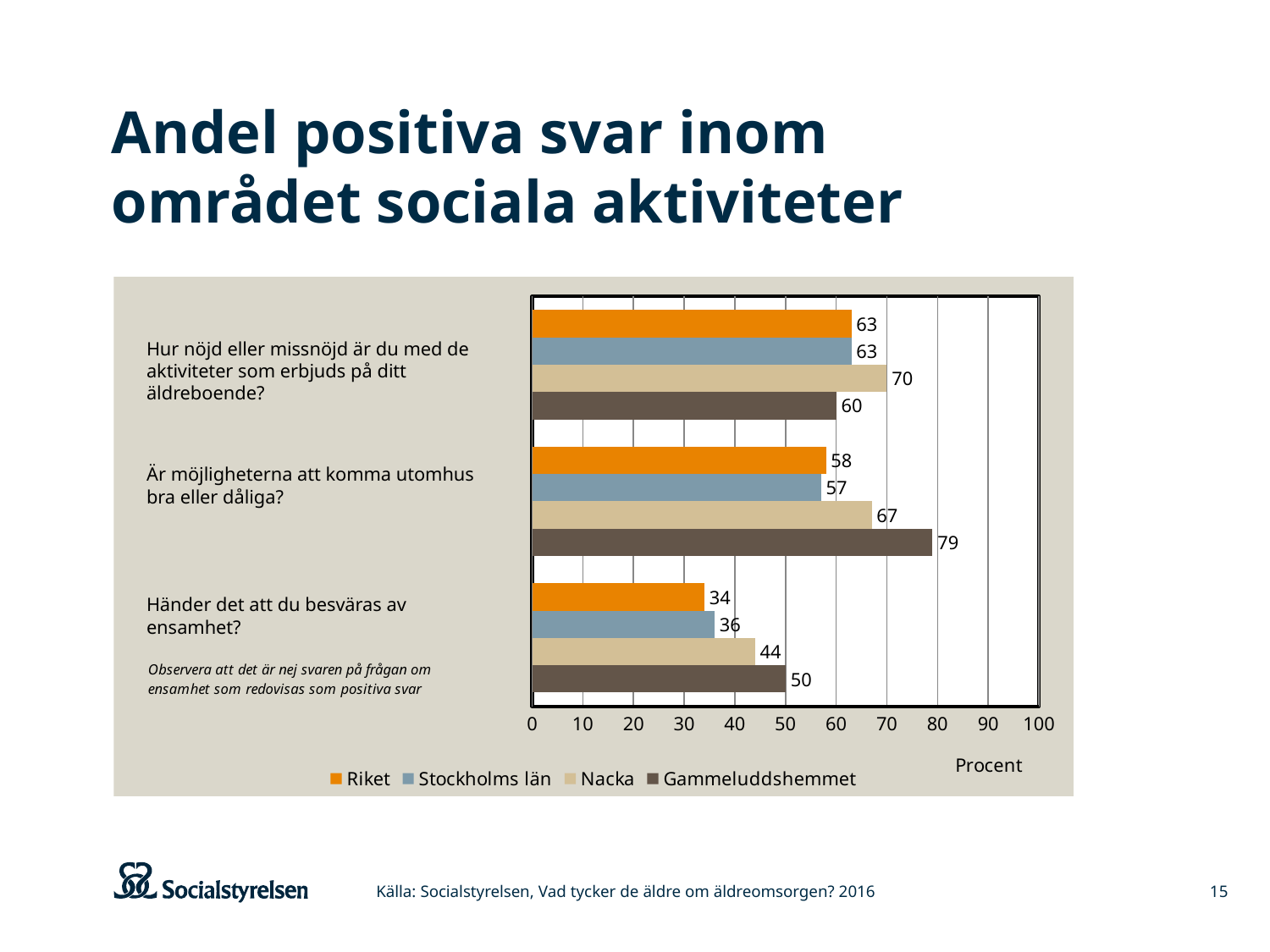
How many series does the legend list? 4 What is the value for Gammeluddshemmet on the question "Är möjligheterna att komma utomhus bra eller dåliga?"? 79 What is the difference between Gammeluddshemmet and Riket on the question "Är möjligheterna att komma utomhus bra eller dåliga?"? 21 Which series has the lowest value on the question "Hur nöjd eller missnöjd är du med de aktiviteter som erbjuds på ditt äldreboende?"? Gammeluddshemmet How many questions (categories) are shown on the chart? 3 What is the value for Riket on the question "Händer det att du besväras av ensamhet?"? 34 What is the value for Nacka on the question "Hur nöjd eller missnöjd är du med de aktiviteter som erbjuds på ditt äldreboende?"? 70 What kind of chart is shown on the slide? Bar chart Which series has the highest value on the question "Är möjligheterna att komma utomhus bra eller dåliga?"? Gammeluddshemmet What is the label on the horizontal axis of the chart? Procent Which is larger on the question "Händer det att du besväras av ensamhet?": Gammeluddshemmet or Nacka? Gammeluddshemmet What is the difference between Nacka and Stockholms län on the question "Händer det att du besväras av ensamhet?"? 8